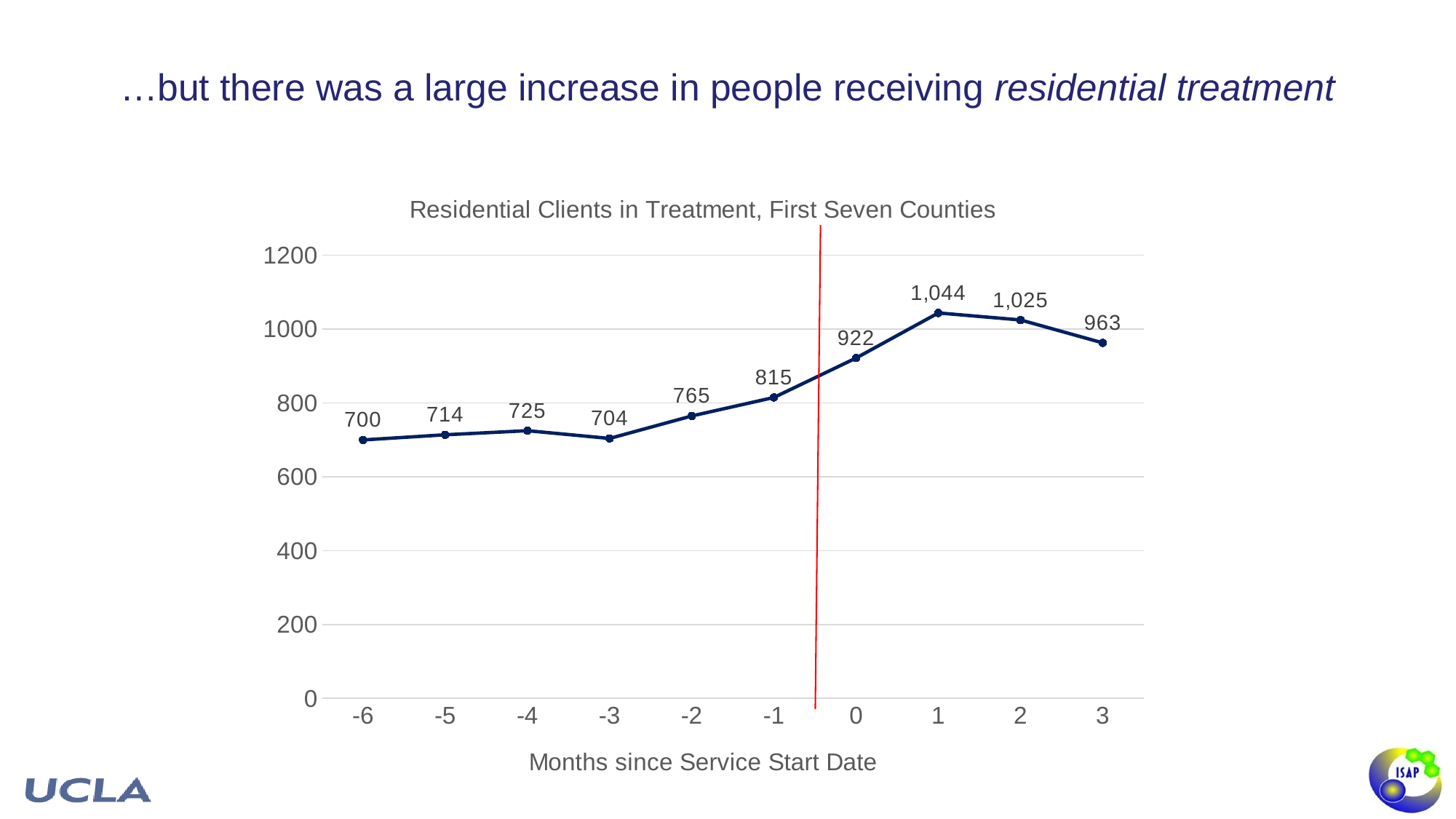
What is the value at month 3? 963 At which month is the number of residential clients lowest? -6 What is the value at month -6? 700 At which month is the number of residential clients highest? 1 Is the value at month 2 greater or less than 1000? greater What is the difference between the values at month 1 and month -1? 229 Do the values rise or fall from month -3 to month 1? Rise What kind of chart is shown on the slide? Line chart What is the title of the chart? Residential Clients in Treatment, First Seven Counties How many data points are plotted on the chart? 10 Which is larger, the value at month -3 or the value at month -2? -2 What is the number of residential clients in treatment at month 0? 922